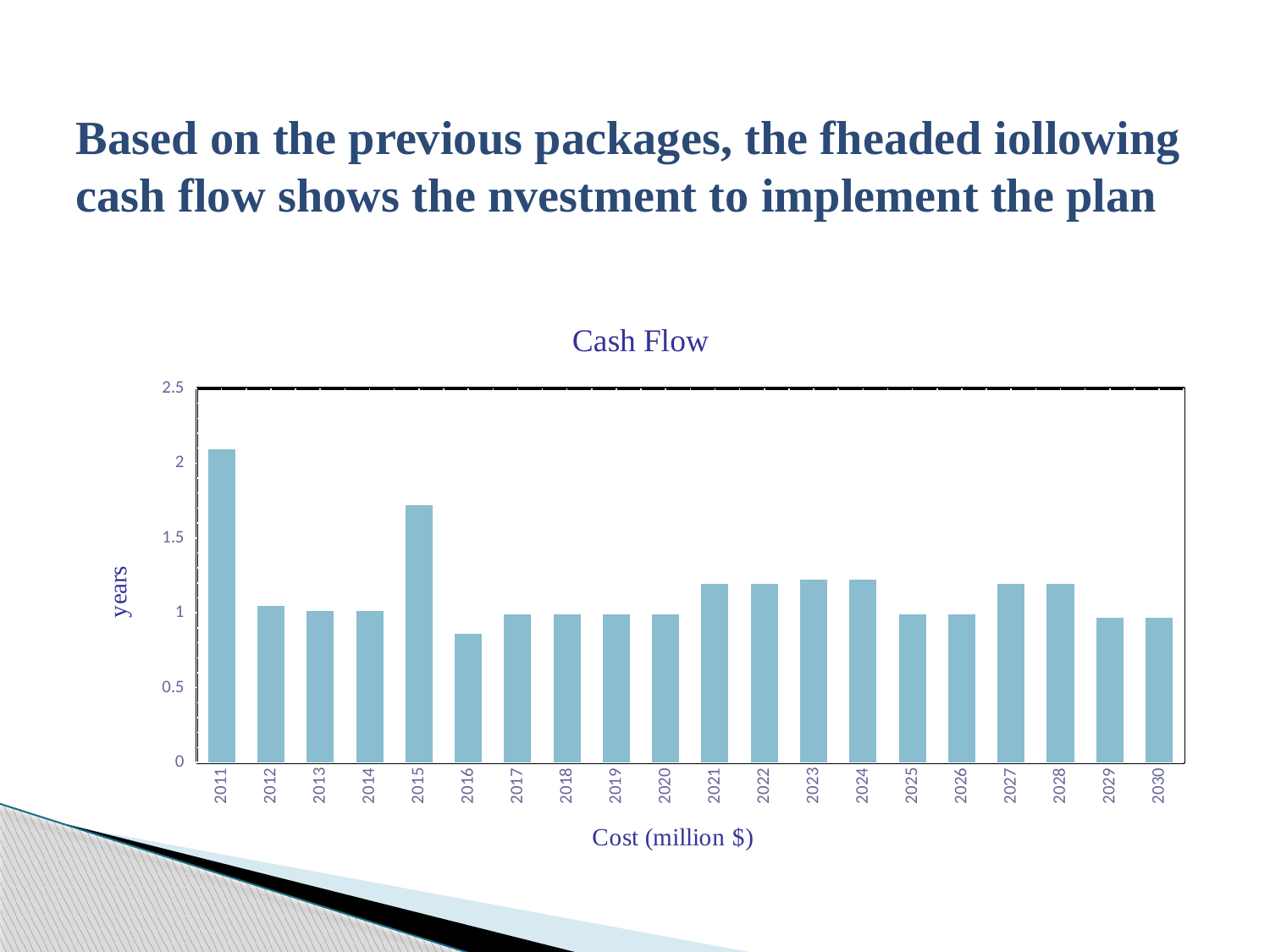
Which year has the larger value, 2011 or 2015? 2011 What type of chart is shown on the slide? bar chart How many years (bars) are plotted in the chart? 20 Is the value for 2016 greater or less than 1? less What is the label on the horizontal axis of the chart? Cost (million $) Do the values rise or fall from 2011 to 2014? fall Which year has the highest bar in the chart? 2011 Is the value for 2011 greater or less than 2? greater Is the value for 2023 greater or less than 1? greater Which year has the lowest bar in the chart? 2016 What is the title of the chart? Cash Flow